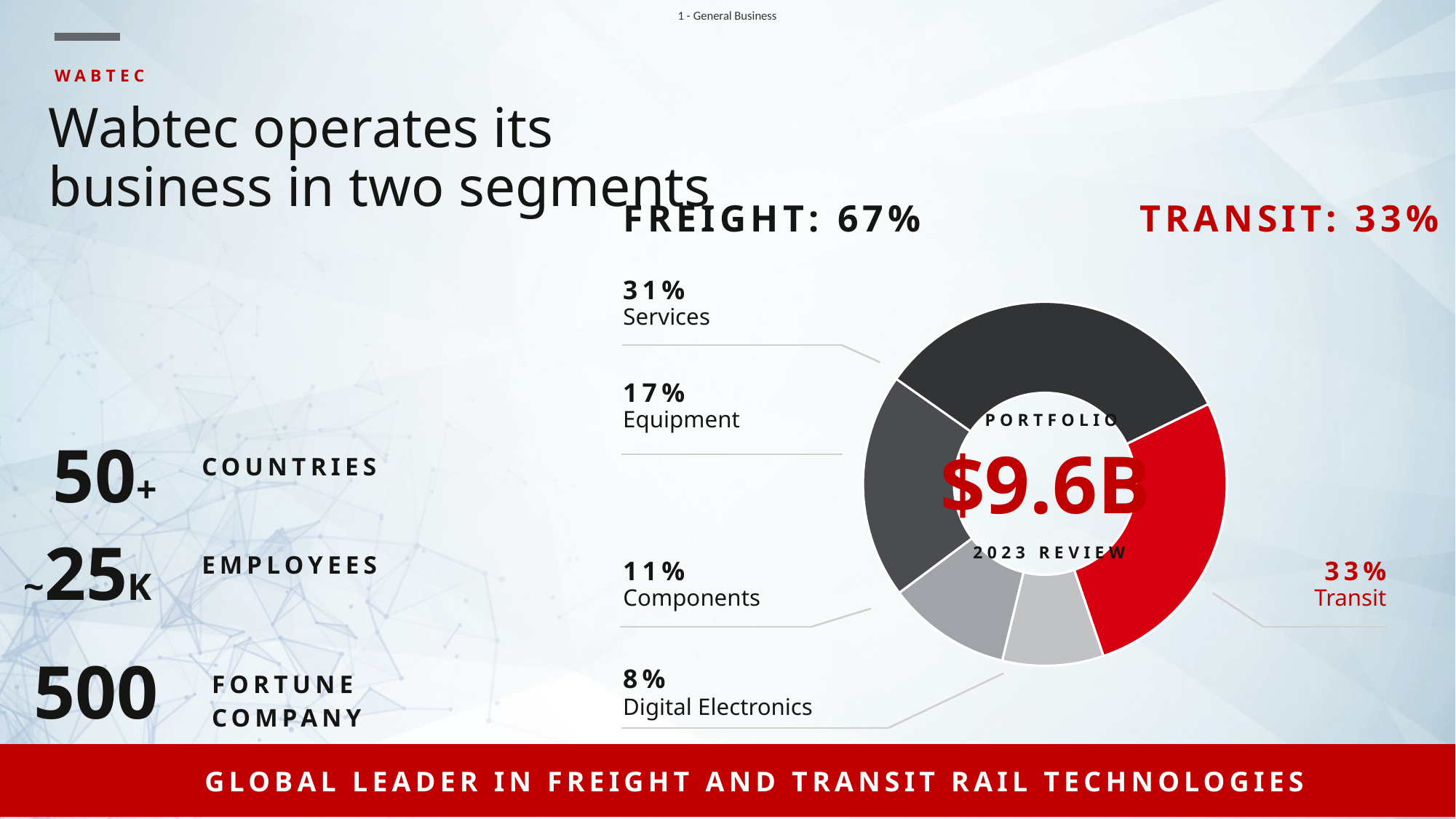
What kind of chart is shown on the slide? Donut (pie) chart What share of the portfolio does Components represent? 11% Which slice of the donut chart is the smallest? Digital Electronics What share of the portfolio does Digital Electronics represent? 8% What total portfolio value is shown in the centre of the donut chart? $9.6B What share of the portfolio does Equipment represent? 17% Which is larger, the Components slice or the Digital Electronics slice? Components Which slice of the donut chart is the largest? Transit What share of the portfolio does Transit represent? 33% What is the difference in percentage points between the Services and Equipment slices? 14 percentage points How many slices does the donut chart have? 5 What share of the portfolio does Services represent? 31%